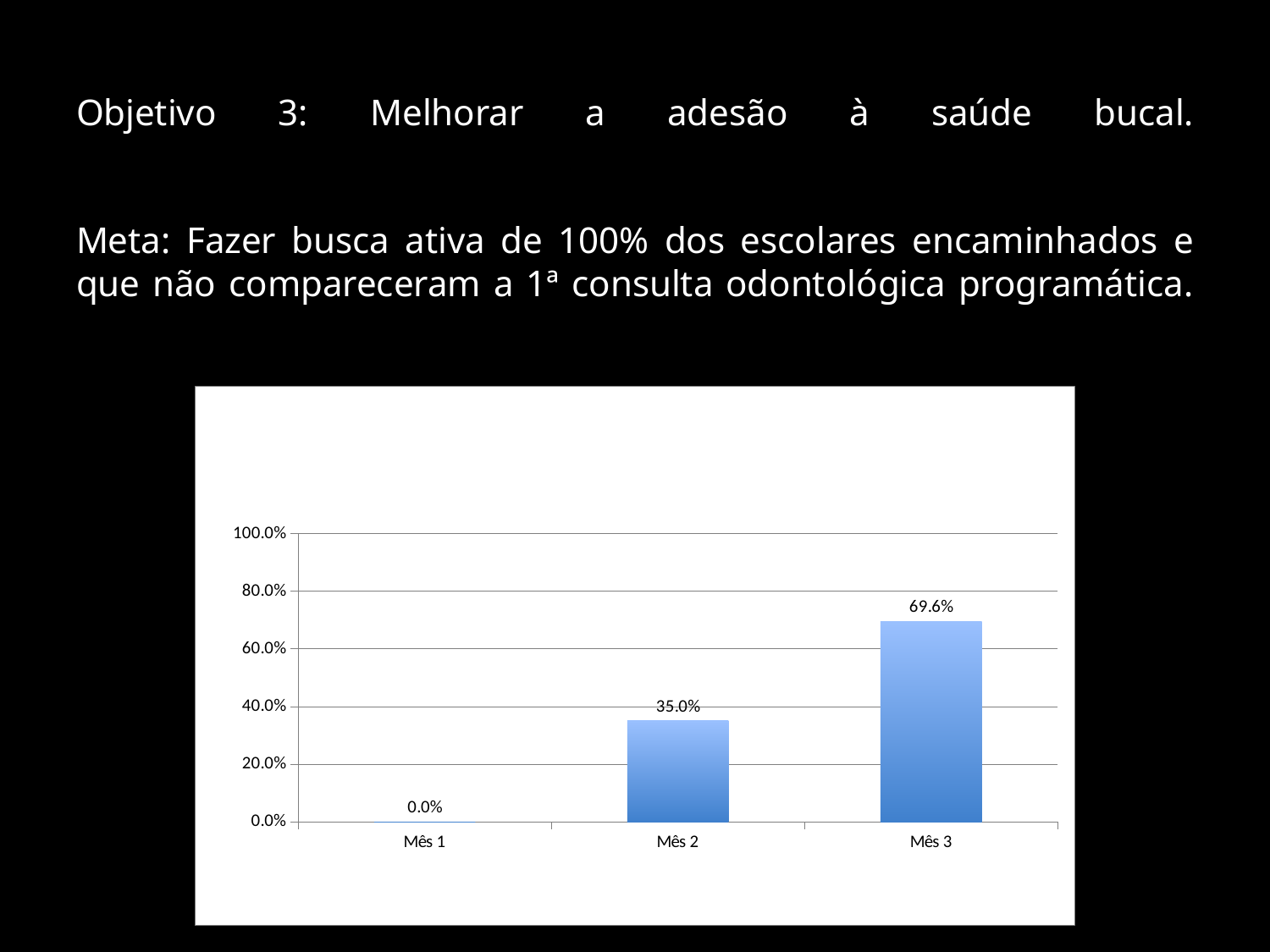
Is the value for Mês 2 greater or less than 40.0%? less Which is larger, the value for Mês 2 or the value for Mês 3? Mês 3 What is the value for Mês 1? 0.0% Do the values rise or fall from Mês 1 to Mês 3? rise Which month has the lowest value? Mês 1 Which month has the highest value? Mês 3 How many categories are shown on the x axis? 3 What kind of chart is shown on the slide? bar chart What is the difference between the values for Mês 3 and Mês 2? 34.6% What is the value for Mês 2? 35.0% What is the value for Mês 3? 69.6% Is the value for Mês 3 greater or less than 60.0%? greater